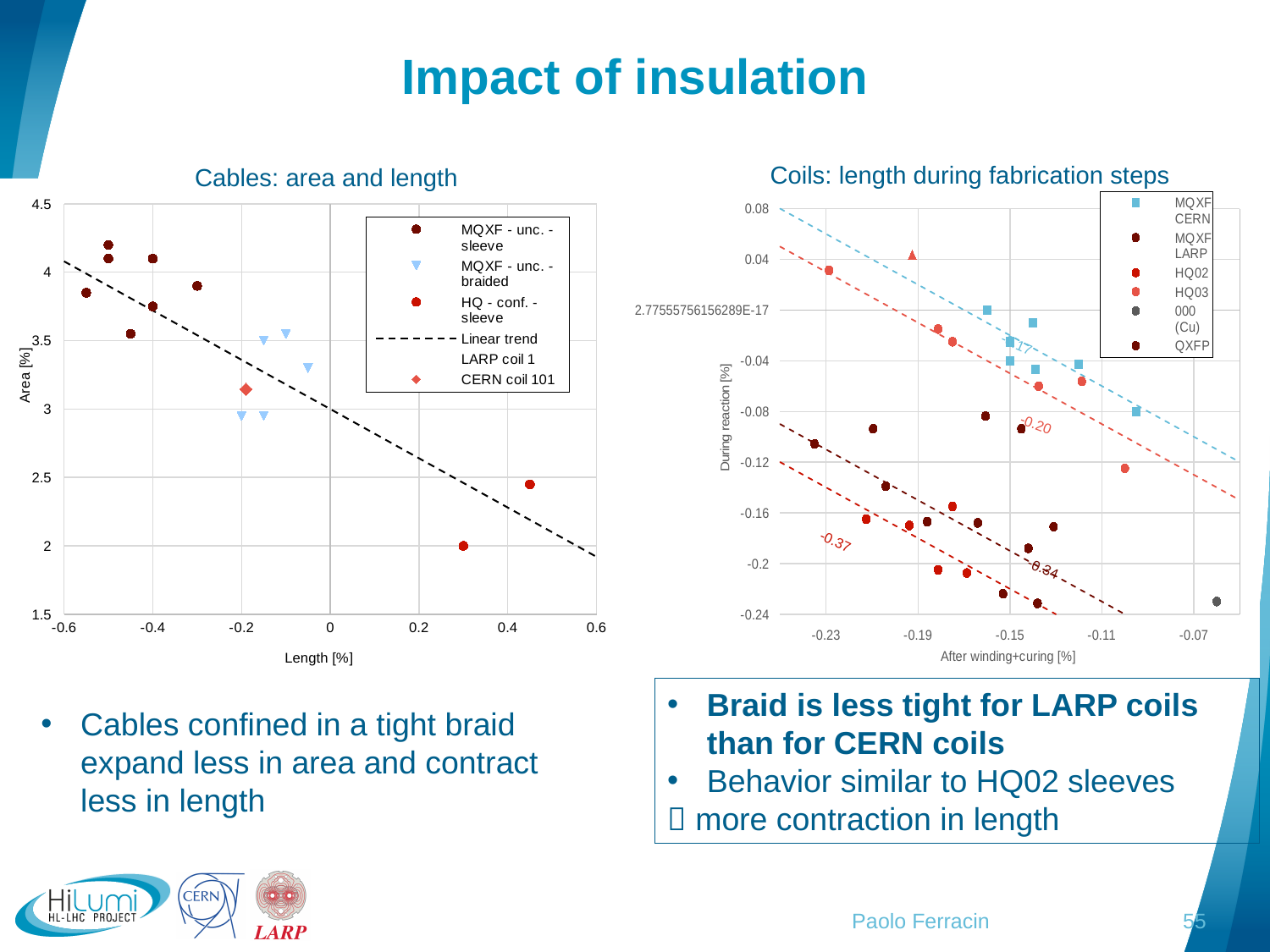
In the 'Cables: area and length' chart, do the 'HQ - conf. - sleeve' points have larger or smaller area than the 'MQXF - unc. - sleeve' points? smaller How many series does the legend of the 'Coils: length during fabrication steps' chart list? 6 How many series does the legend of the 'Cables: area and length' chart list? 6 In the 'Coils: length during fabrication steps' chart, is the 'During reaction' value of the '000 (Cu)' point greater or less than -0.2? less What kind of chart is the 'Cables: area and length' chart on the left? scatter chart In the 'Cables: area and length' chart, does the linear trend line rise or fall as length increases? fall In the 'Coils: length during fabrication steps' chart, what is the title of the y axis? During reaction [%] In the 'Cables: area and length' chart, how many 'HQ - conf. - sleeve' points are plotted? 2 What kind of chart is the 'Coils: length during fabrication steps' chart on the right? scatter chart In the 'Cables: area and length' chart, are the area values of the 'HQ - conf. - sleeve' points greater or less than 3? less In the 'Cables: area and length' chart, what is the title of the x axis? Length [%] In the 'Cables: area and length' chart, are the length values of the 'MQXF - unc. - sleeve' points greater or less than 0? less